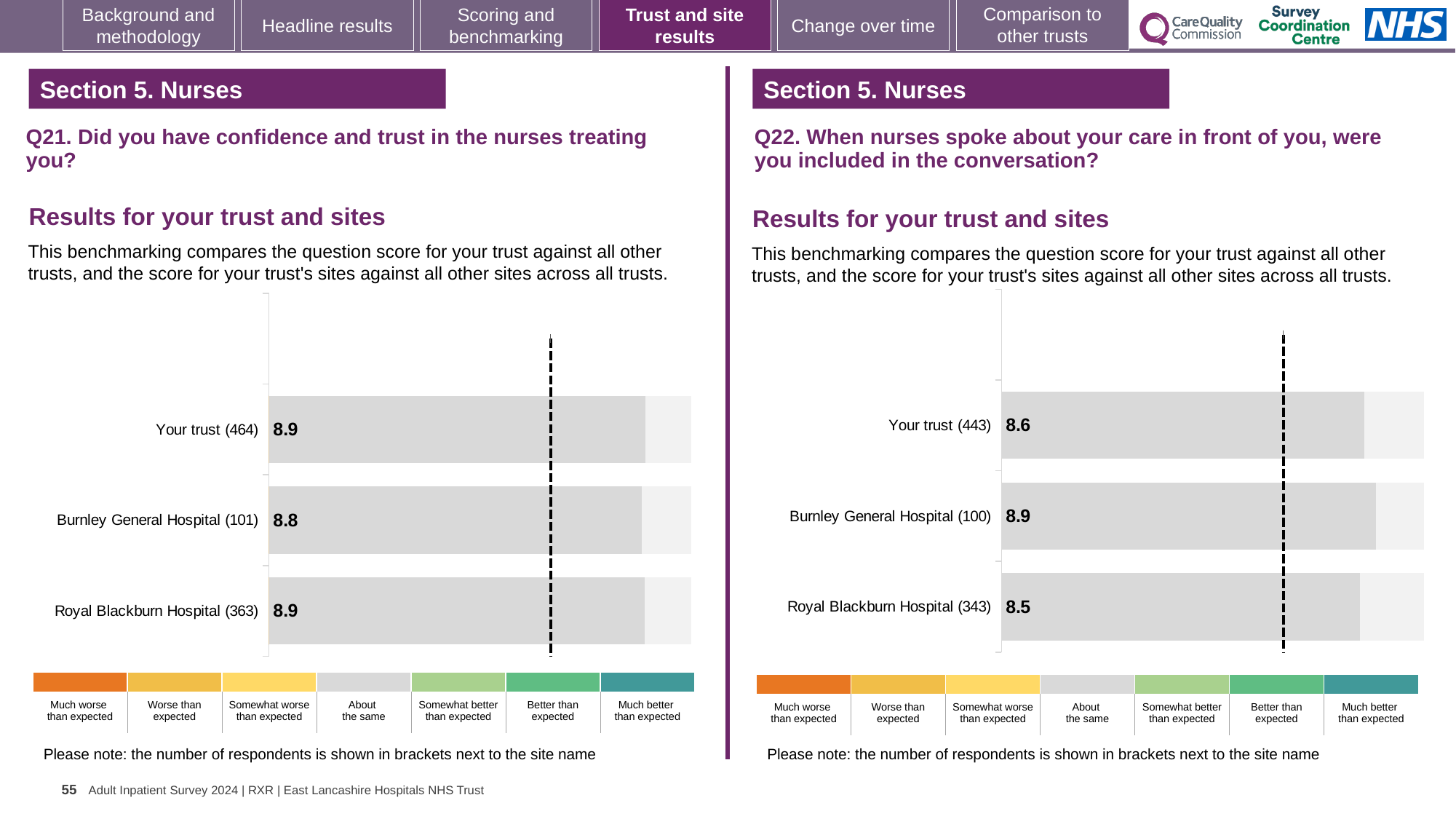
On the Q21 chart (left), what is the score for Your trust? 8.9 What type of chart is used on the Q22 chart (right)? Bar chart On the Q22 chart (right), how many respondents are shown in brackets for Your trust? 443 On the Q22 chart (right), which site or trust has the highest score? Burnley General Hospital On the Q22 chart (right), which site or trust has the lowest score? Royal Blackburn Hospital How many bars are shown on the Q21 chart (left)? 3 On the Q22 chart (right), what is the score for Your trust? 8.6 On the Q22 chart (right), which has the larger score, Your trust or Burnley General Hospital? Burnley General Hospital On the Q22 chart (right), what is the score for Royal Blackburn Hospital? 8.5 On the Q21 chart (left), which has the lowest score? Burnley General Hospital On the Q22 chart (right), what is the difference between the scores for Burnley General Hospital and Royal Blackburn Hospital? 0.4 On the Q21 chart (left), what is the score for Burnley General Hospital? 8.8